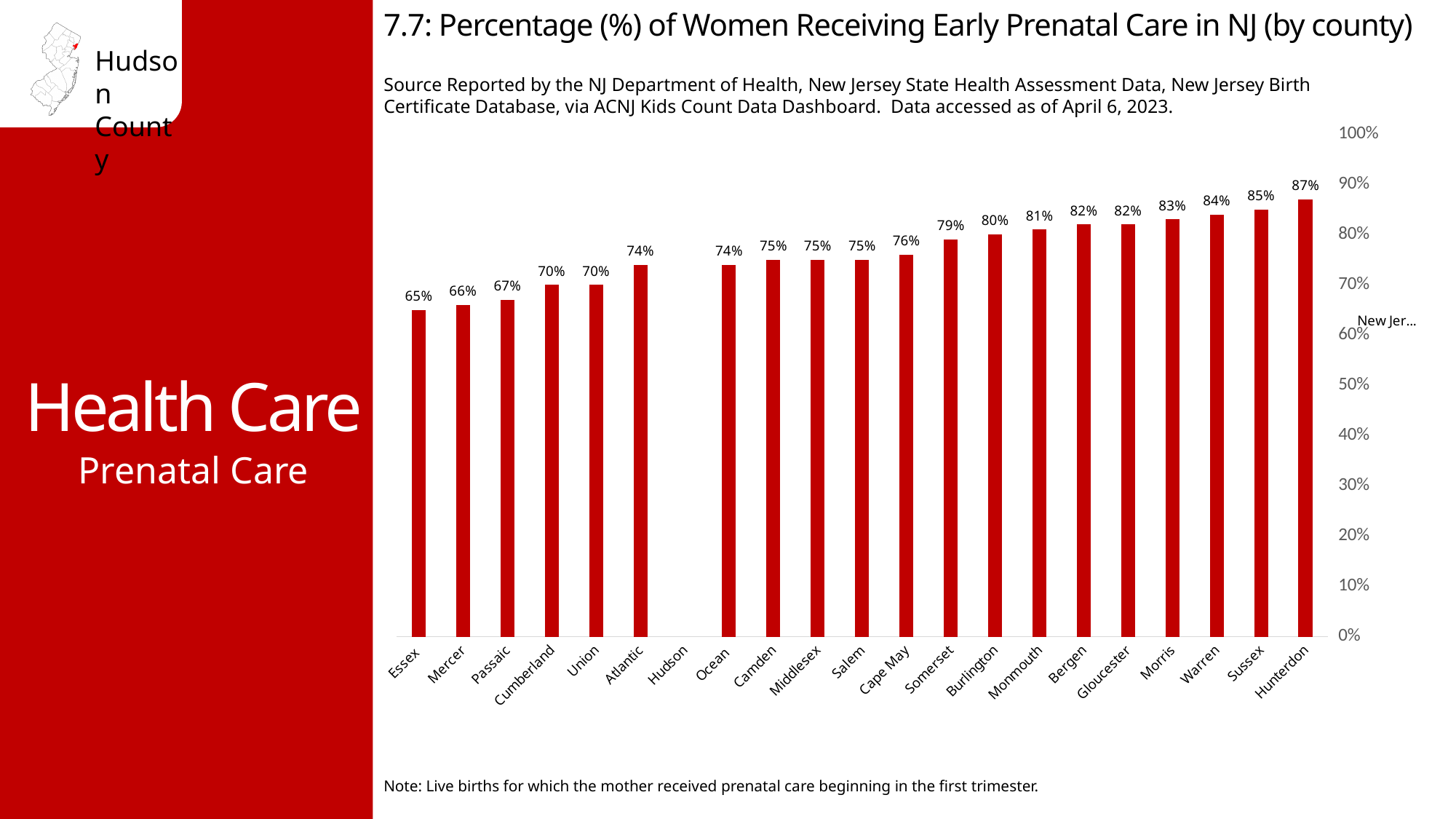
Is the value for Morris county greater or less than 80%? greater What percentage of women received early prenatal care in Essex county? 65% How many county labels are shown along the x axis? 21 Do the bar values generally rise or fall from left to right across the chart? Rise Which county has the highest percentage of women receiving early prenatal care? Hunterdon Which county has a higher value, Bergen or Cape May? Bergen Which county on the x axis has no bar plotted? Hudson What is the value shown for Somerset county? 79% Which county has the lowest percentage of women receiving early prenatal care? Essex What is the value shown for Hunterdon county? 87% What is the difference between the values for Hunterdon and Essex? 22% What kind of chart is shown on the slide? Bar chart